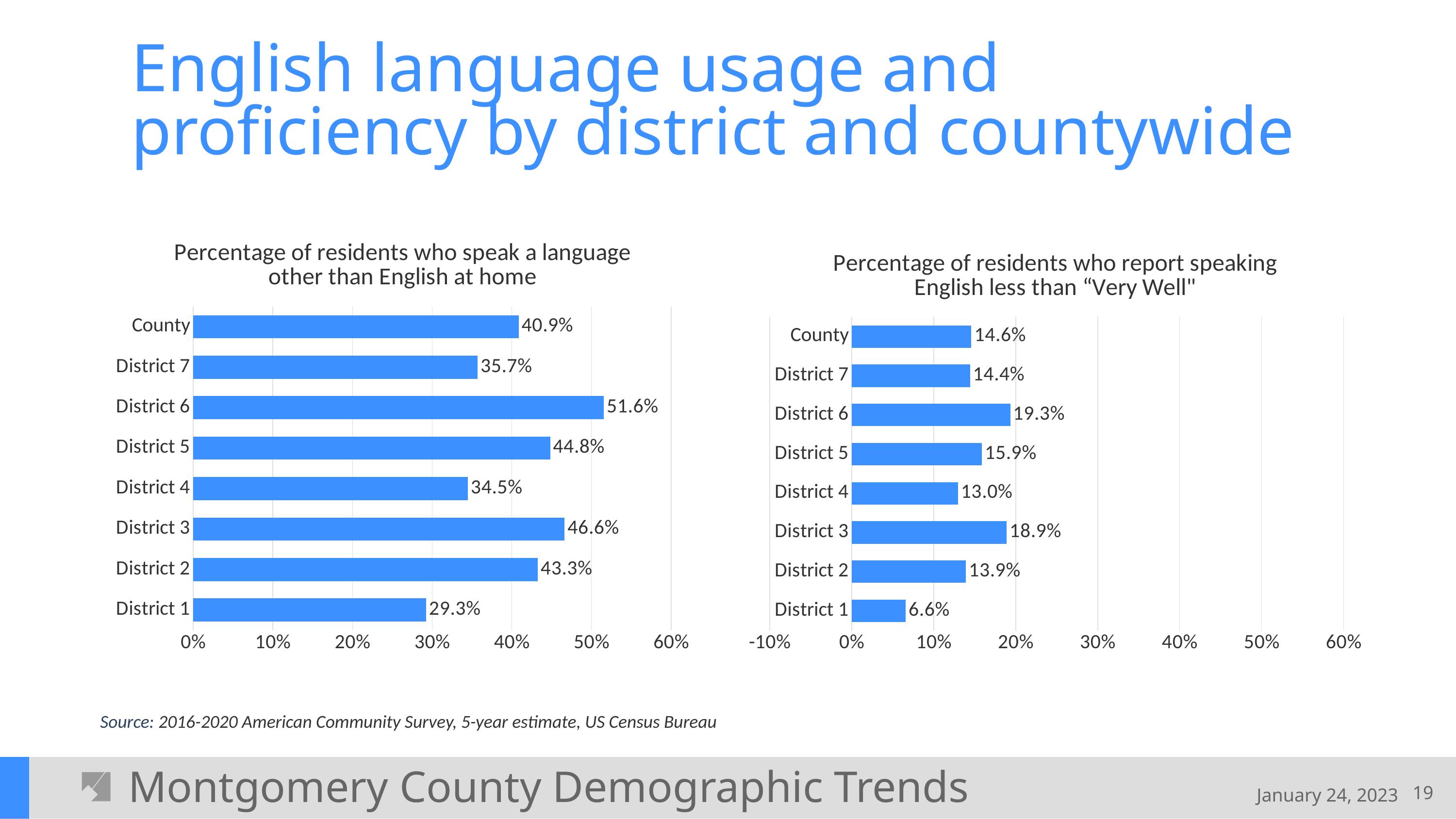
How many categories are plotted in the left chart (language other than English at home)? 8 In the left chart (language other than English at home), which category has the lowest value? District 1 In the chart 'Percentage of residents who speak a language other than English at home', what is the value for District 6? 51.6% In the left chart (language other than English at home), which is larger, District 3 or District 2? District 3 In the chart 'Percentage of residents who report speaking English less than "Very Well"', what is the value for County? 14.6% In the right chart (speaking English less than "Very Well"), which category has the lowest value? District 1 In the right chart (speaking English less than "Very Well"), is the value for District 5 greater or less than 10%? greater In the left chart (language other than English at home), what is the difference between District 6 and District 1? 22.3% What kind of chart is the right chart (speaking English less than "Very Well")? Bar chart In the right chart (speaking English less than "Very Well"), what is the difference between District 3 and District 4? 5.9% In the left chart (language other than English at home), which category has the highest value? District 6 In the right chart (speaking English less than "Very Well"), which category has the highest value? District 6